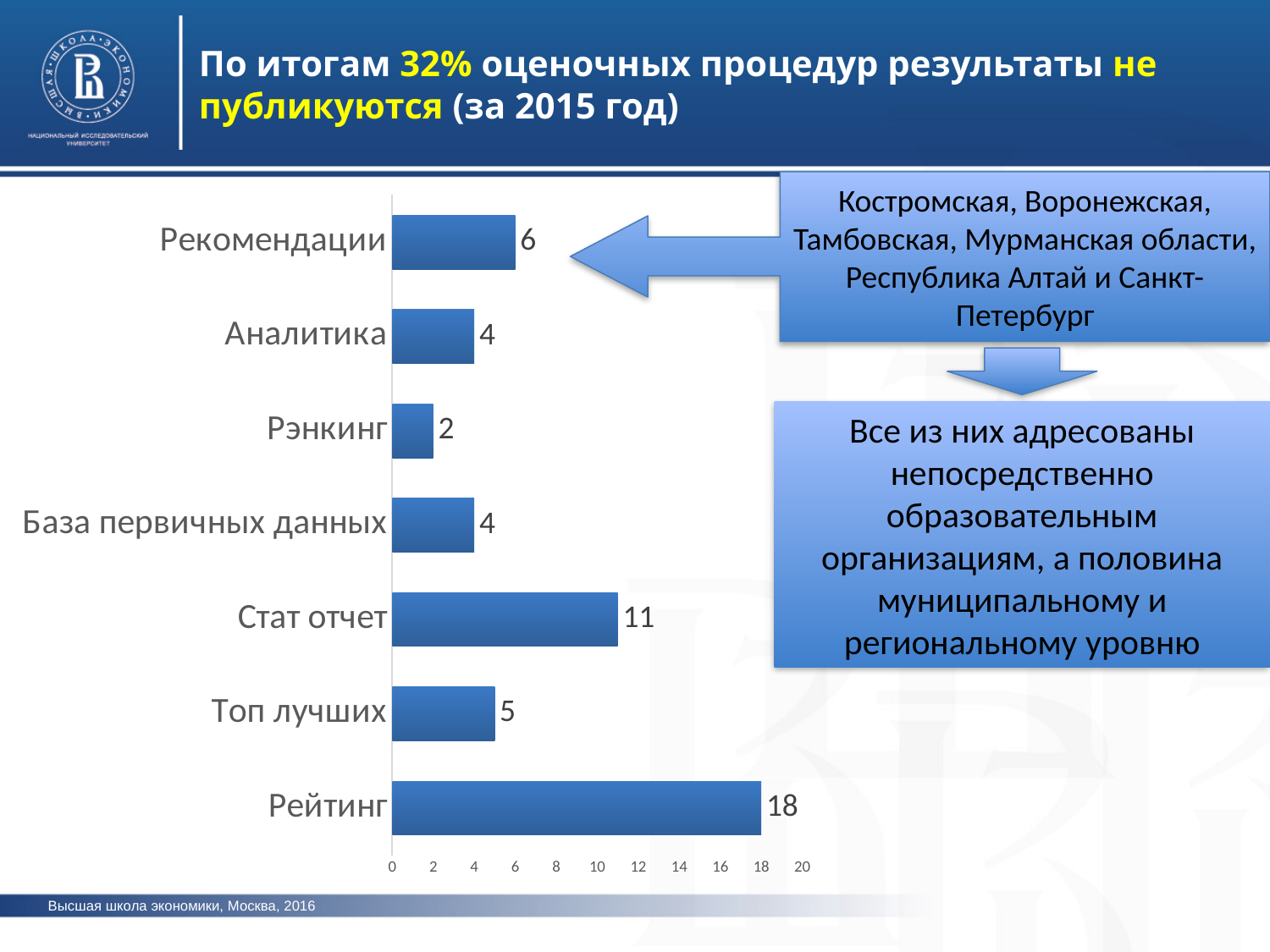
How many categories are shown in the chart? 7 Which category has the lowest value? Рэнкинг What is the difference between the values for Рейтинг and Стат отчет? 7 What is the value for Рейтинг? 18 What is the value for Топ лучших? 5 What is the value for Рекомендации? 6 Which category has the highest value? Рейтинг Is the value for Стат отчет greater or less than 10? greater Which is larger, the value for Рекомендации or the value for Топ лучших? Рекомендации What kind of chart is shown on the slide? bar chart What is the value for Стат отчет? 11 What is the value for Аналитика? 4